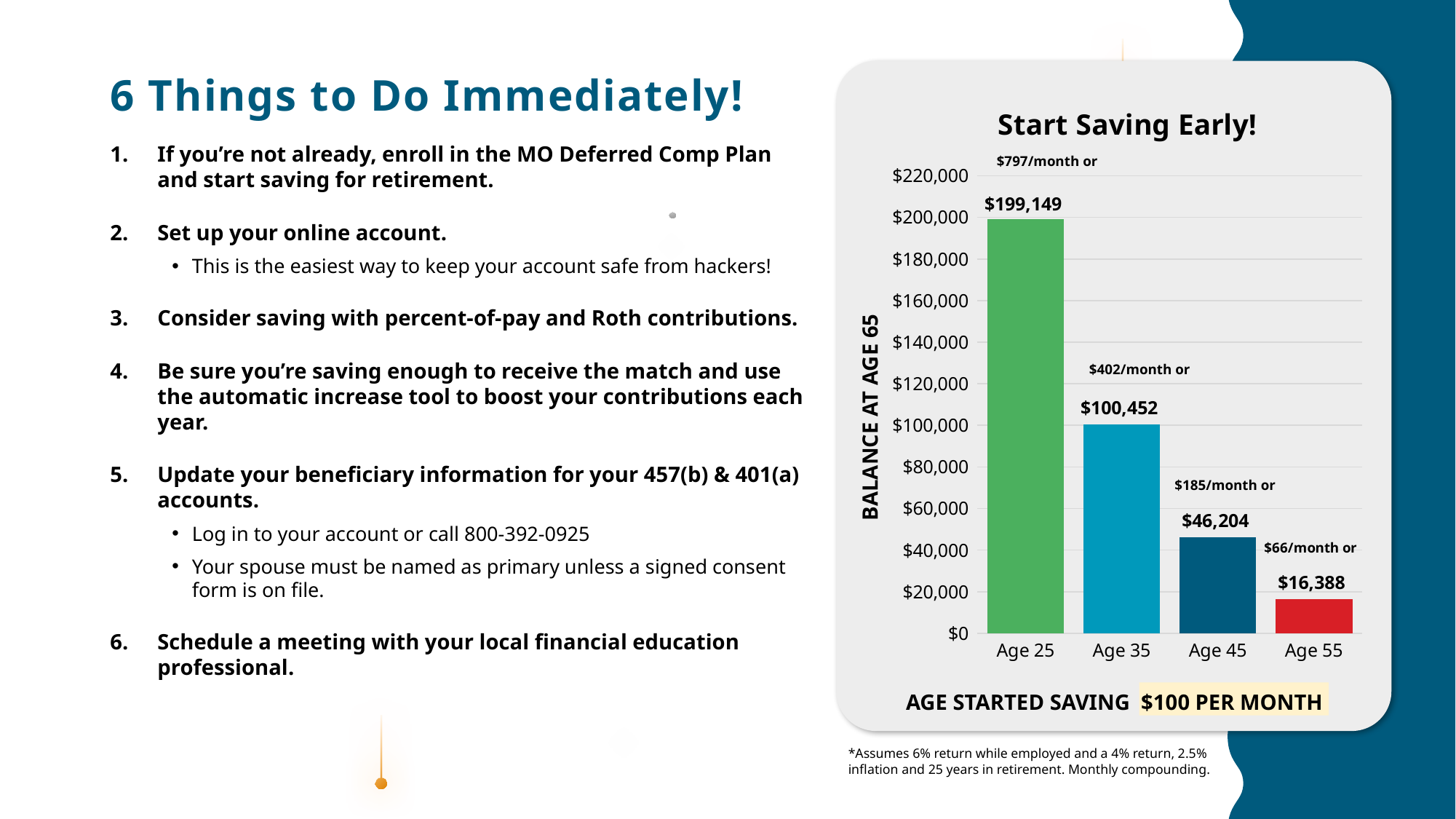
Which starting age gives the lowest balance at age 65? Age 55 Which starting age gives the highest balance at age 65? Age 25 What is the balance at age 65 for someone who started saving at Age 45? $46,204 Do the balances rise or fall as the starting age increases along the x axis? Fall What is the difference between the balance for Age 25 and the balance for Age 35? $98,697 What kind of chart is shown on the slide? Bar chart What is the balance at age 65 for someone who started saving at Age 35? $100,452 What is the title of the chart? Start Saving Early! What is the balance at age 65 for someone who started saving at Age 25? $199,149 What is the balance at age 65 for someone who started saving at Age 55? $16,388 Which has a larger balance at age 65: Age 35 or Age 45? Age 35 How many starting-age categories are shown in the chart? 4